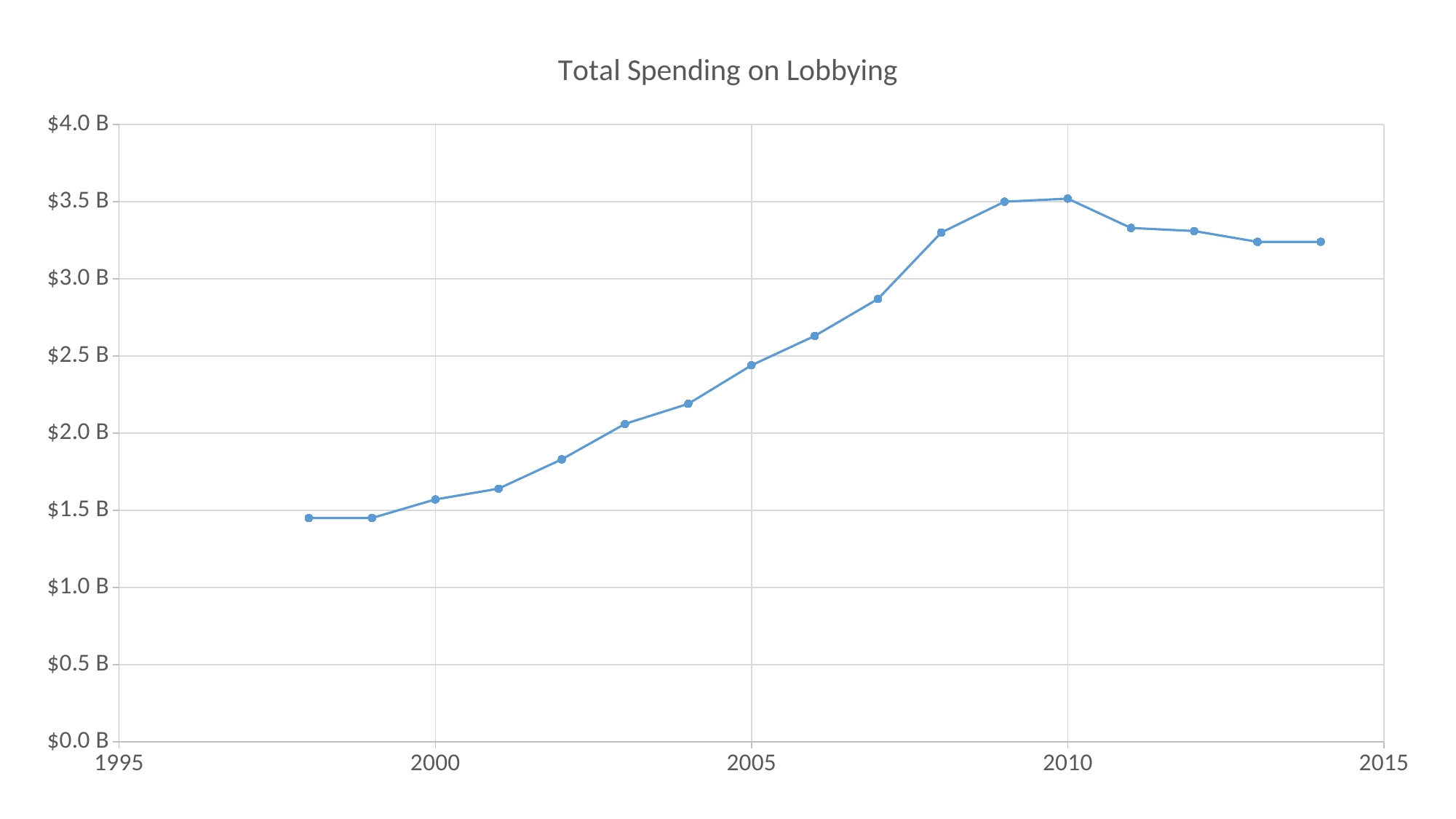
Do the values rise or fall between 2000 and 2008? rise How many data points are plotted on the line? 17 Is the value for 2000 greater or less than $2.0 B? less What is the title of the chart? Total Spending on Lobbying Is the value for 2005 greater or less than $2.0 B? greater Which year has the larger value, 2000 or 2005? 2005 Which year has the larger value, 2010 or 2014? 2010 Do the values rise or fall between 2010 and 2014? fall Is the value for 2010 greater or less than $3.0 B? greater What kind of chart is shown on the slide? line chart